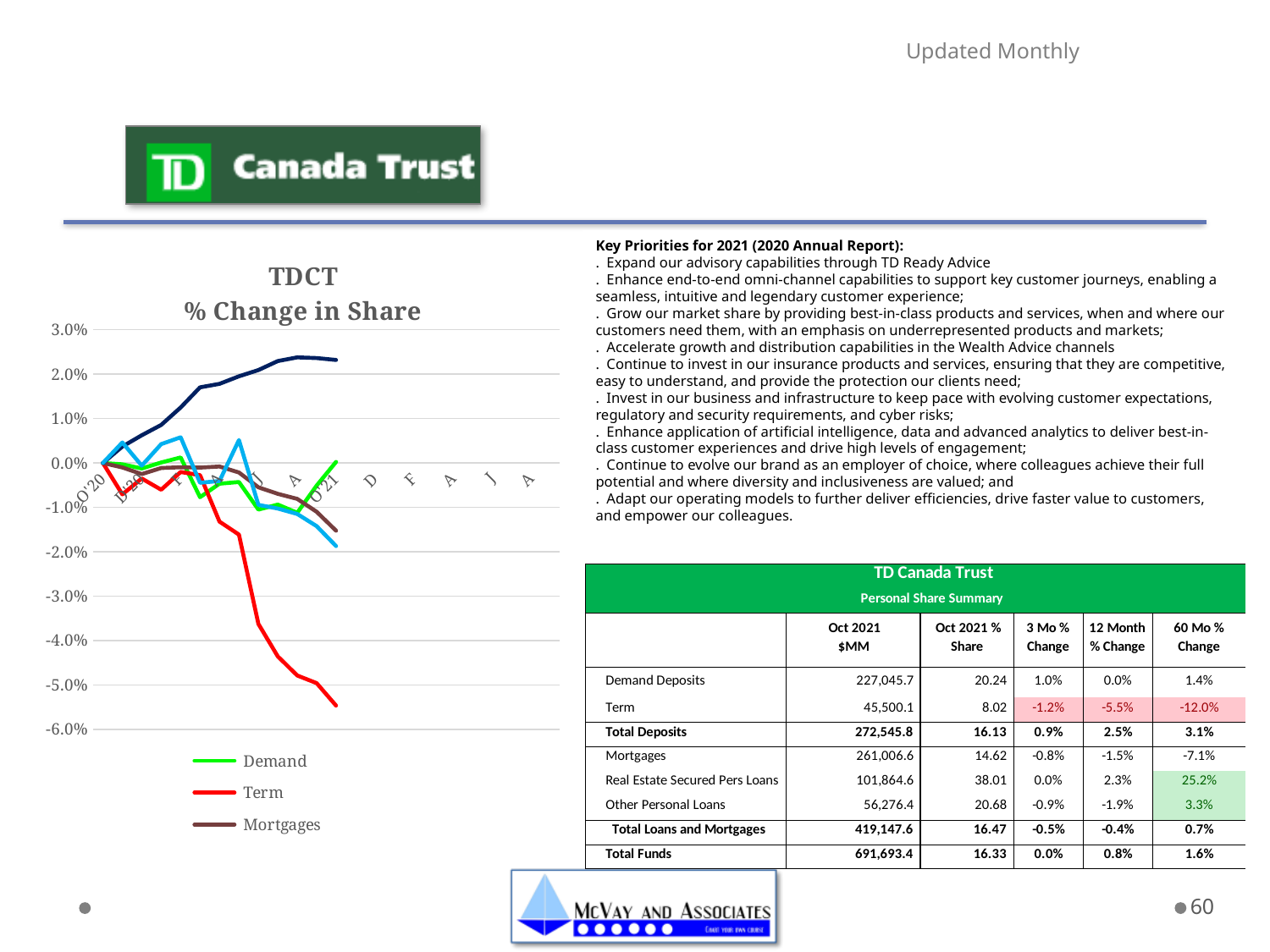
Is the lowest value of the Demand line greater or less than -2.0%? greater Is the lowest value of the Term line greater or less than -4.0%? less What kind of chart is shown on the slide? line chart What colour is the Term line in the chart? red How many series does the chart legend list? 3 Which series in the legend reaches the lowest value on the chart? Term What is the title of the chart? TDCT % Change in Share Is the final value of the Mortgages line greater or less than -3.0%? greater What is the highest value shown on the chart's y axis? 3.0% Does the Term line rise or fall along the x axis? fall At the right end of the chart, which is higher, the Demand line or the Term line? Demand